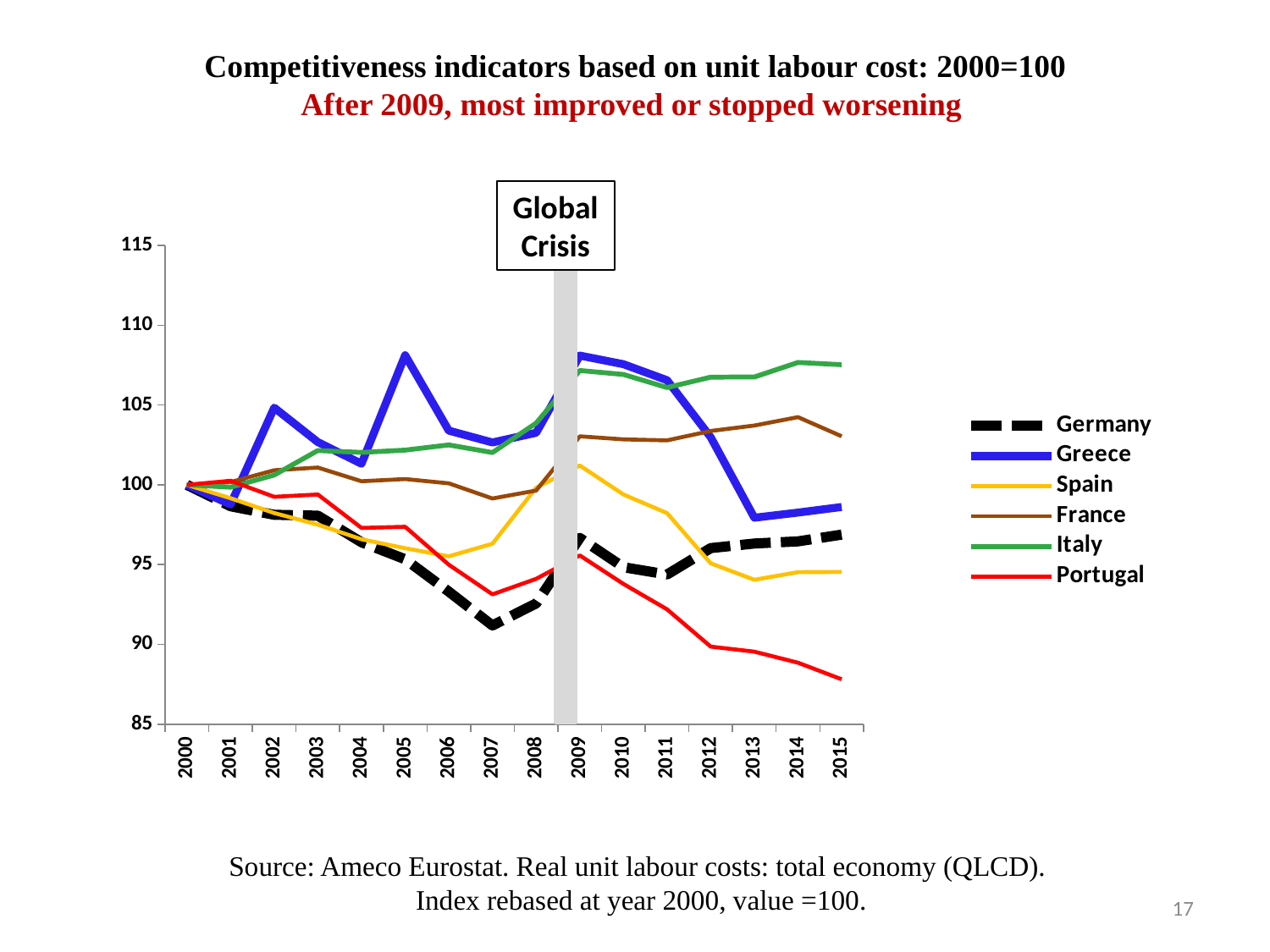
What kind of chart is shown on the slide? line chart Which country has the lowest value in 2015? Portugal How many years are plotted along the x axis? 16 How many series does the legend list? 6 Which country has the highest value in 2015? Italy Is the value for Germany in 2007 greater or less than 95? less Which country is drawn as a dashed black line? Germany In 2013, which is higher: Greece or Spain? Greece Is the value for Italy in 2015 greater or less than 105? greater Is the value for Portugal in 2015 greater or less than 90? less Which country has the highest value in 2009? Greece Does the value for Portugal rise or fall from 2009 to 2015? fall